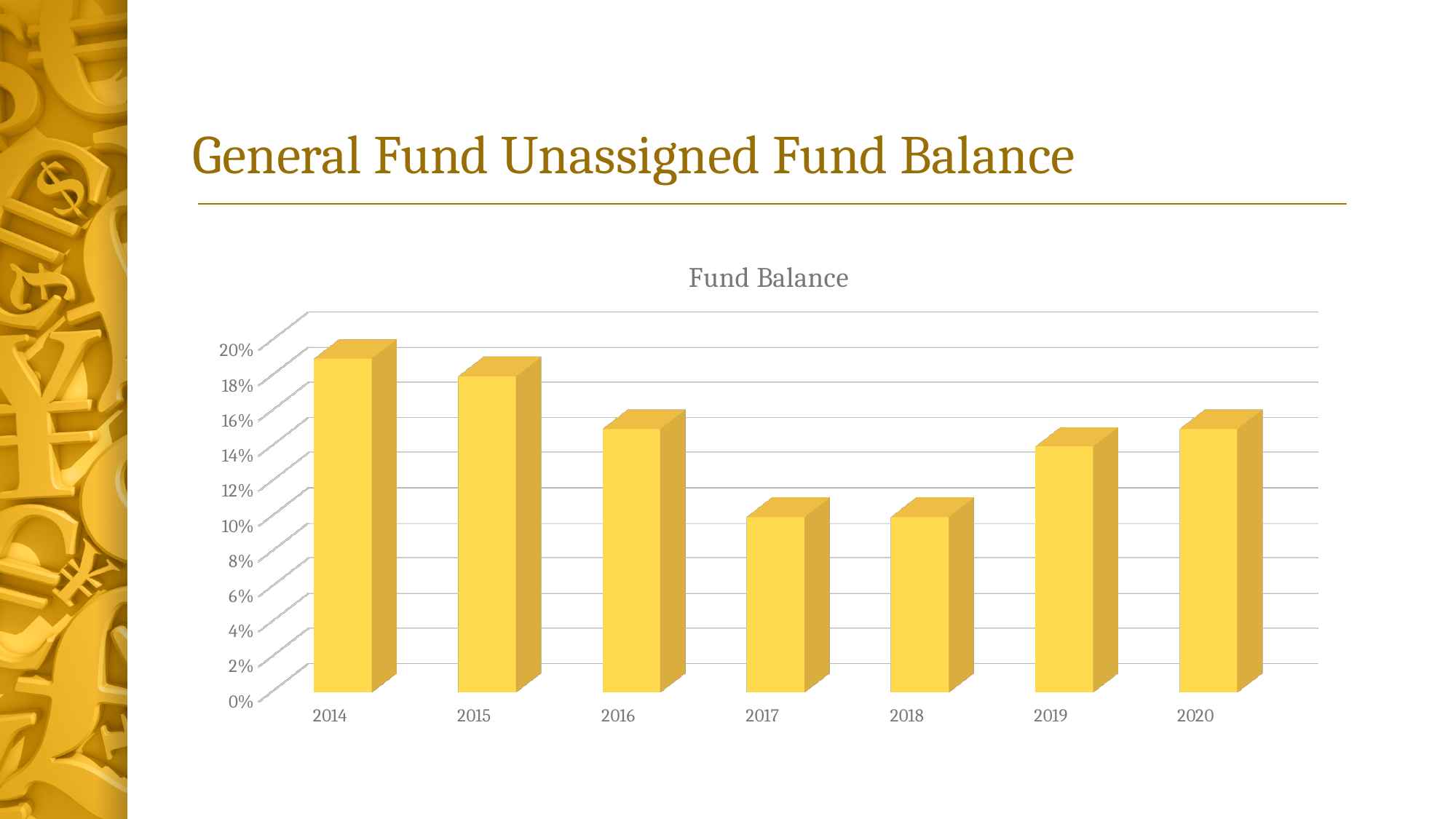
Which year has the larger fund balance, 2020 or 2017? 2020 Is the fund balance for 2016 greater or less than 18%? less How many years are shown on the x axis of the Fund Balance chart? 7 Is the fund balance for 2019 greater or less than 12%? greater Is the fund balance for 2017 greater or less than 12%? less What kind of chart is shown on the slide? bar chart Which year has the larger fund balance, 2014 or 2015? 2014 Which year has the highest fund balance in the chart? 2014 What is the title of the chart? Fund Balance Do the fund balance values rise or fall from 2014 to 2017? fall